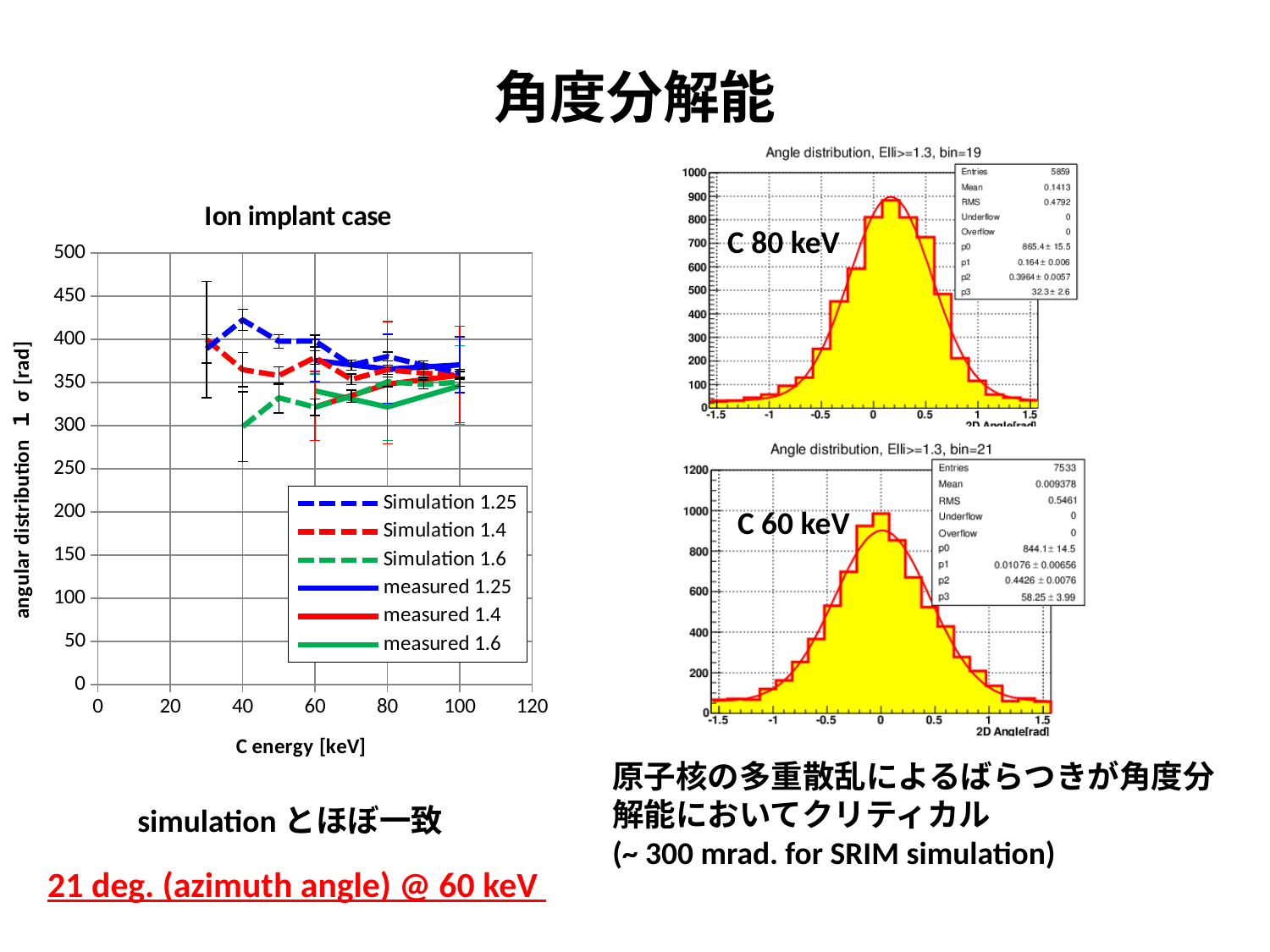
In the 'Ion implant case' chart, which series has the lowest value at 40 keV? Simulation 1.6 In the C 60 keV angle distribution histogram, what is the RMS listed in the statistics box? 0.5461 In the C 80 keV angle distribution histogram, how many entries are listed in the statistics box? 5859 In the 'Ion implant case' chart, which series has the highest value at 40 keV? Simulation 1.25 What kind of chart is the 'Ion implant case' chart on the left? line chart What is the x-axis label of the 'Ion implant case' chart? C energy [keV] In the 'Ion implant case' chart, does the Simulation 1.25 series generally rise or fall from 40 keV to 100 keV? fall Which histogram has more entries, the C 80 keV one or the C 60 keV one? C 60 keV In the 'Ion implant case' chart, is the value of measured 1.6 at 80 keV greater or less than 350? less How many series does the legend of the 'Ion implant case' chart list? 6 In the 'Ion implant case' chart, is the value of Simulation 1.25 at 40 keV greater or less than 400? greater What is the difference in entries between the C 60 keV histogram and the C 80 keV histogram? 1674